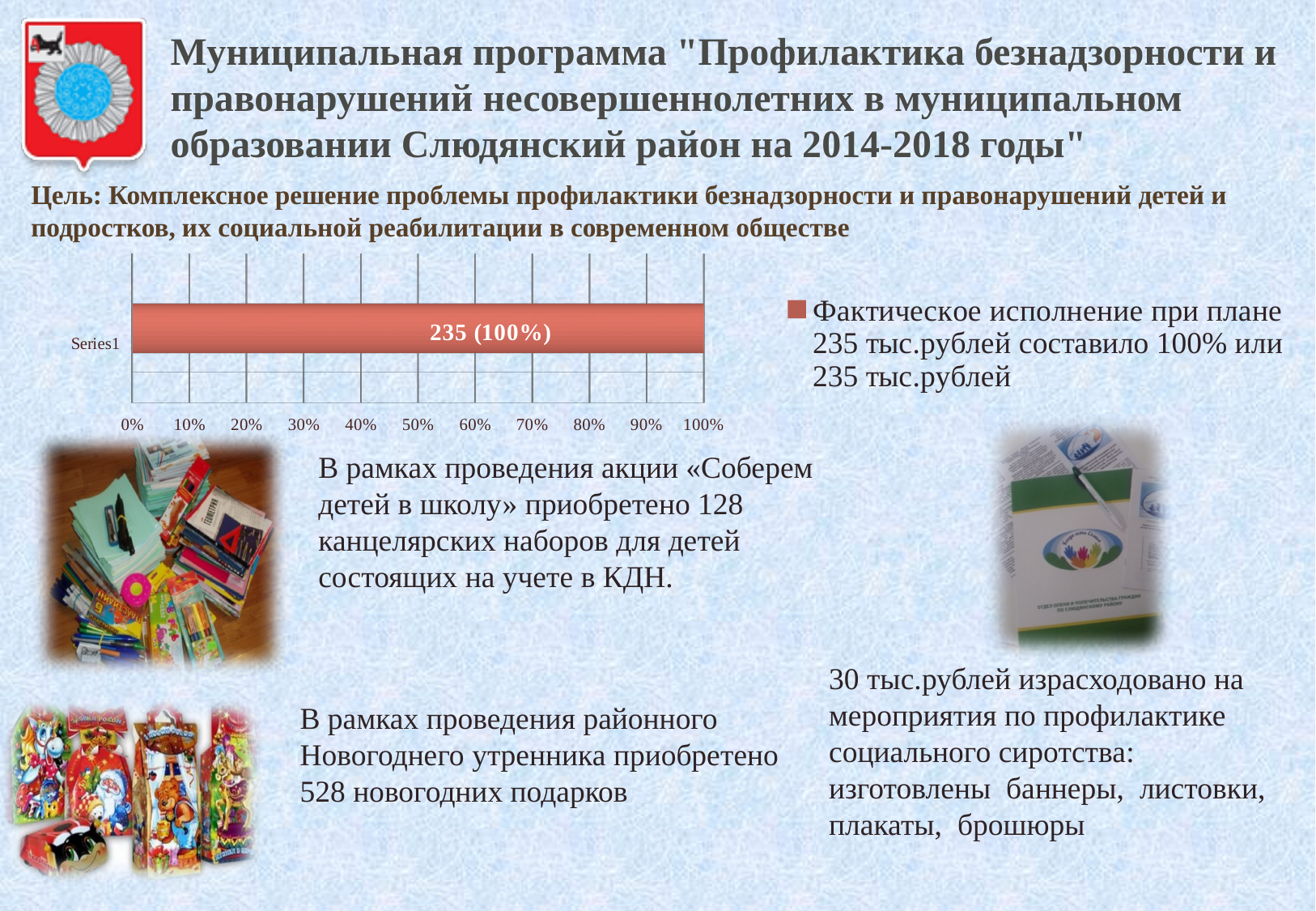
Is the value for Series1 greater or less than 90%? greater What is the category label shown on the vertical axis of the chart? Series1 What is the maximum value shown on the horizontal axis of the chart? 100% What kind of chart is shown on the slide? bar chart How many bars does the chart contain? 1 What is the data label printed on the bar in the chart? 235 (100%) How many series does the legend of the chart list? 1 What percentage does the bar for Series1 reach on the horizontal axis? 100% Is the value for Series1 greater or less than 50%? greater